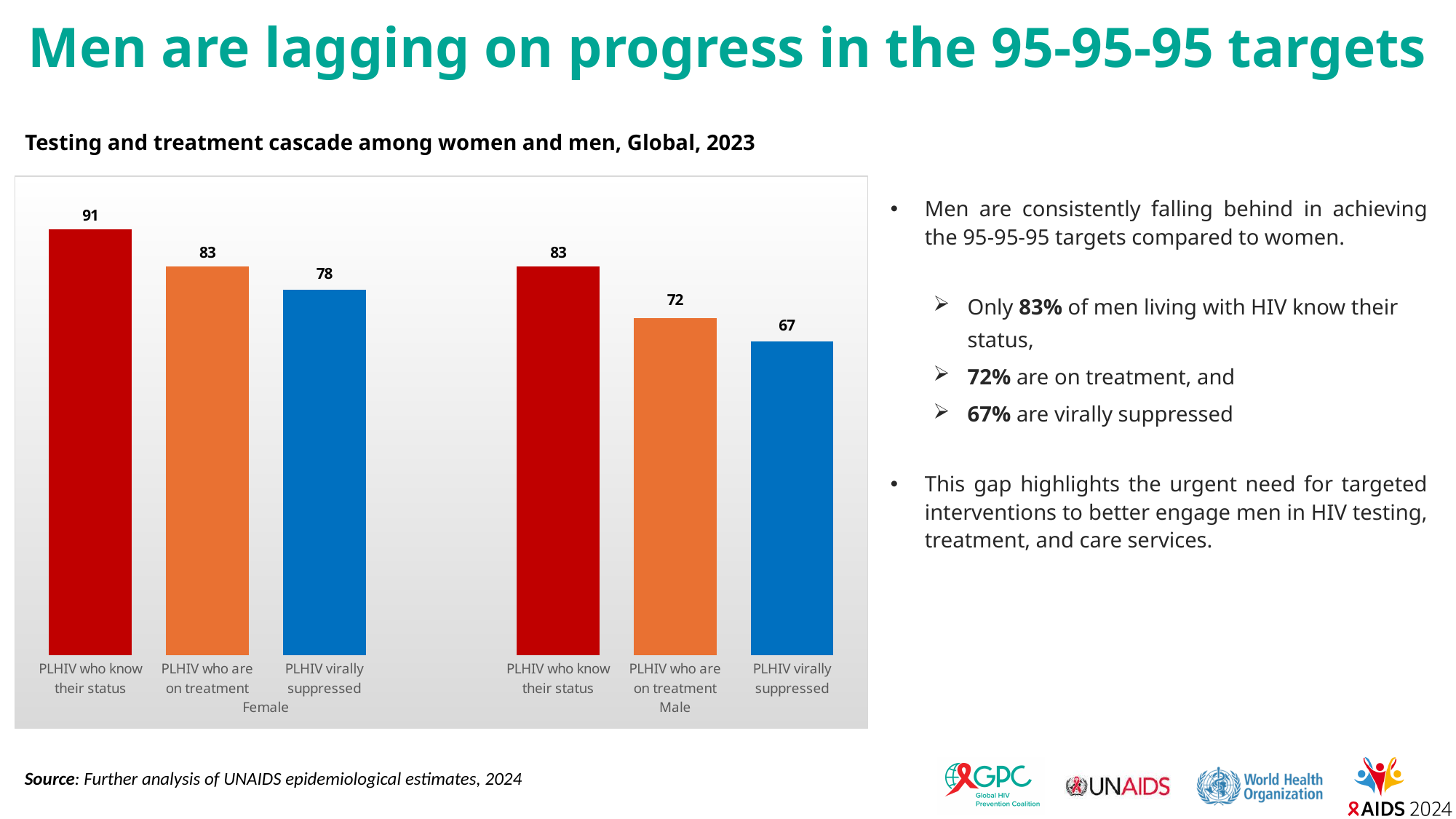
What kind of chart is shown on the slide? Bar chart What is the value for PLHIV virally suppressed among males? 67 Which is larger: PLHIV virally suppressed among females or PLHIV on treatment among males? PLHIV virally suppressed among females Do the values rise or fall across the three cascade stages within each sex group? Fall What is the value for PLHIV who are on treatment among males? 72 Which bar has the lowest value in the chart? PLHIV virally suppressed (Male) How many bars are plotted in the chart? 6 Which is larger: PLHIV on treatment among females or PLHIV who know their status among males? They are equal (83) What is the difference between the female and male values for PLHIV who know their status? 8 What is the value for PLHIV who know their status among females? 91 Which bar has the highest value in the chart? PLHIV who know their status (Female) What is the difference between the female and male values for PLHIV virally suppressed? 11